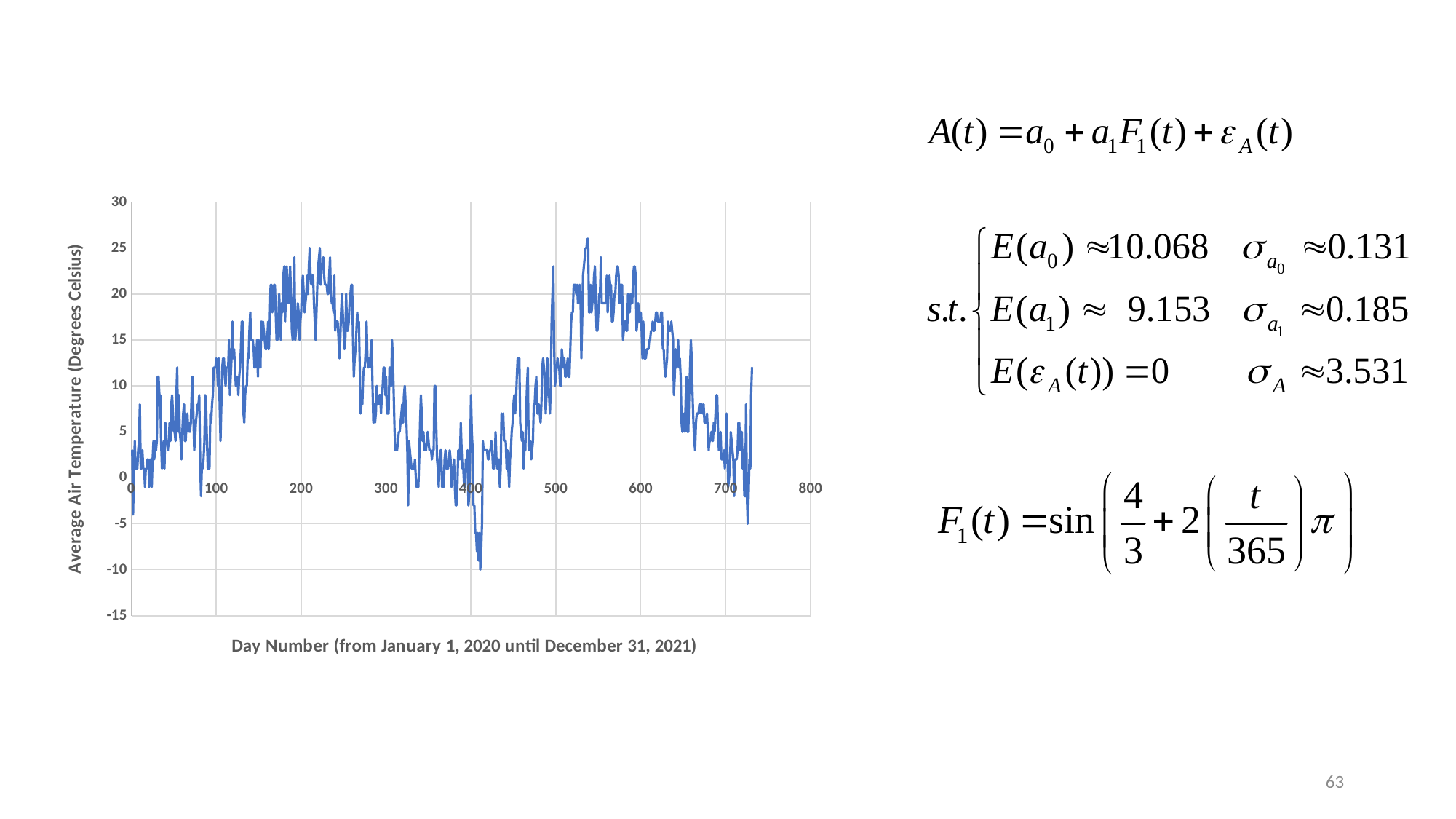
Is the temperature around day 700 greater or less than 10? less What is the label of the x axis of the chart? Day Number (from January 1, 2020 until December 31, 2021) What is the label of the y axis of the chart? Average Air Temperature (Degrees Celsius) How many data series (lines) are plotted on the chart? 1 Is the temperature around day 550 greater or less than 15? greater Does the temperature generally rise or fall between day 0 and day 200? rise Does the temperature generally rise or fall between day 550 and day 700? fall What kind of chart is shown on the slide? line chart Is the lowest temperature plotted on the chart greater or less than -5? less Which is higher, the temperature around day 200 or around day 400? around day 200